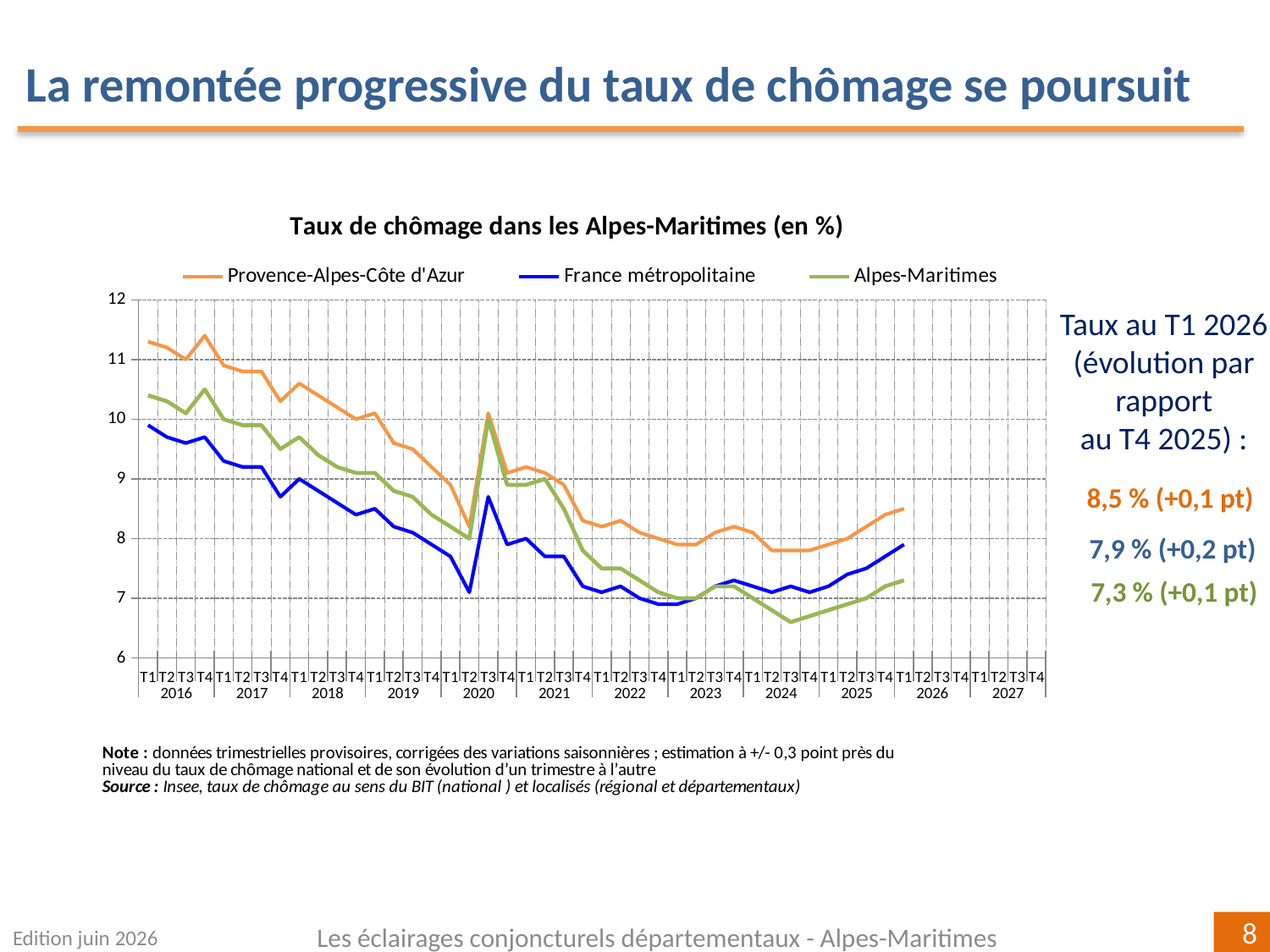
What is the title of the chart? Taux de chômage dans les Alpes-Maritimes (en %) Is the value for Alpes-Maritimes at T3 2024 greater or less than 7? less Does the Alpes-Maritimes line rise or fall between T1 2016 and T4 2019? fall What is the unemployment rate for France métropolitaine at T1 2026? 7,9 % What is the difference between the Provence-Alpes-Côte d'Azur rate and the Alpes-Maritimes rate at T1 2026? 1,2 points Which series has the lowest value at T1 2026? Alpes-Maritimes Which series has the highest value at T1 2026? Provence-Alpes-Côte d'Azur What is the unemployment rate for Alpes-Maritimes at T1 2026? 7,3 % What kind of chart is shown on the slide? line chart By how much did the France métropolitaine rate change between T4 2025 and T1 2026? +0,2 pt How many series does the legend of the chart list? 3 What is the unemployment rate for Provence-Alpes-Côte d'Azur at T1 2026? 8,5 %